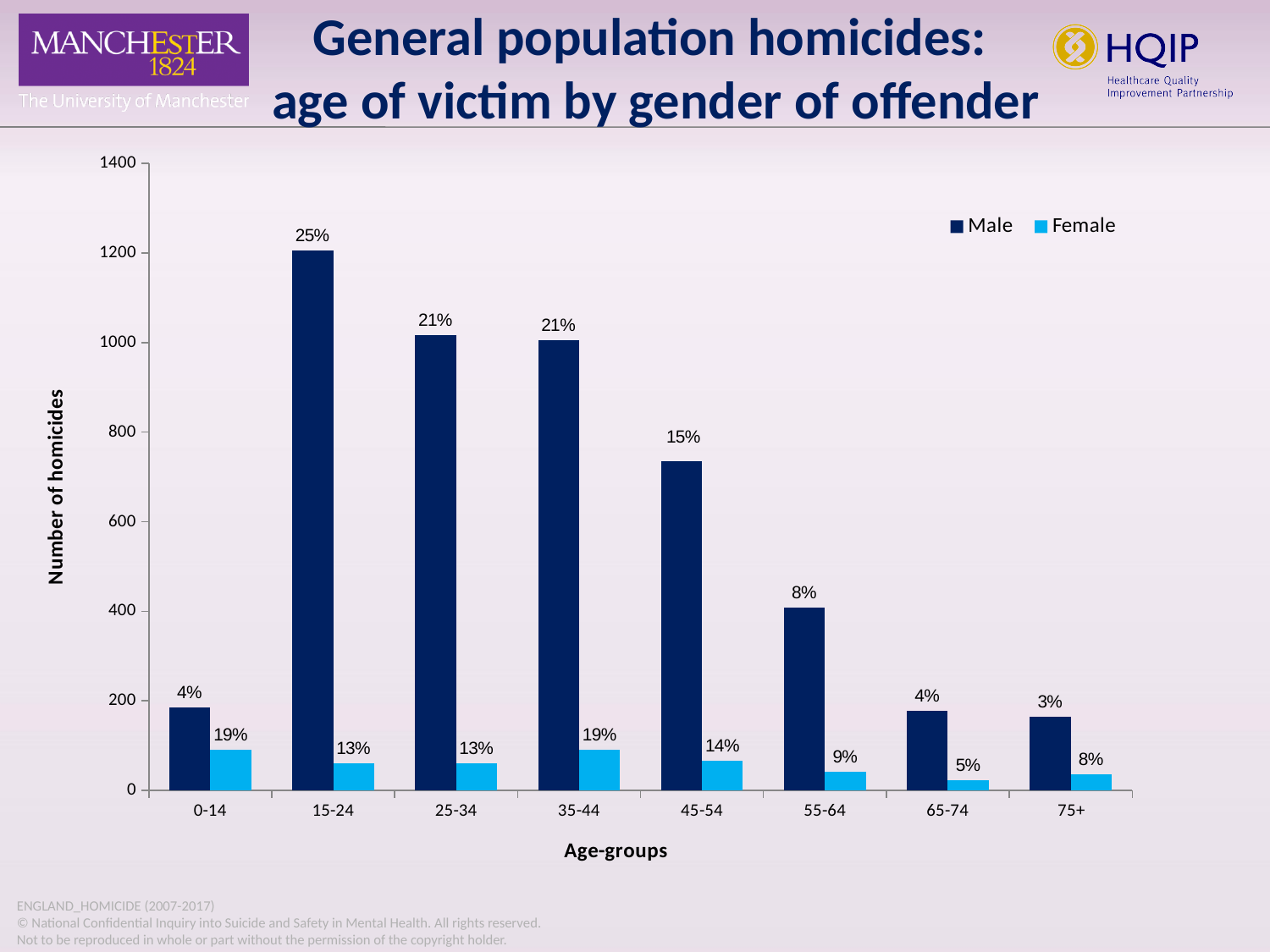
Which age group has the lowest Female percentage label? 65-74 What is the difference in percentage points between the Male labels for the 15-24 and 0-14 age groups? 21 percentage points What percentage label is shown on the Female bar for the 65-74 age group? 5% Which age group has the tallest Male bar? 15-24 Is the Male bar for the 45-54 age group greater or less than 600 homicides? greater How many series does the legend list? 2 How many age groups are shown on the x axis? 8 What percentage label is shown on the Male bar for the 15-24 age group? 25% What percentage label is shown on the Female bar for the 35-44 age group? 19% Is the Male bar for the 55-64 age group greater or less than 600 homicides? less What kind of chart is shown on the slide? Bar chart In the 0-14 age group, which bar is taller, Male or Female? Male